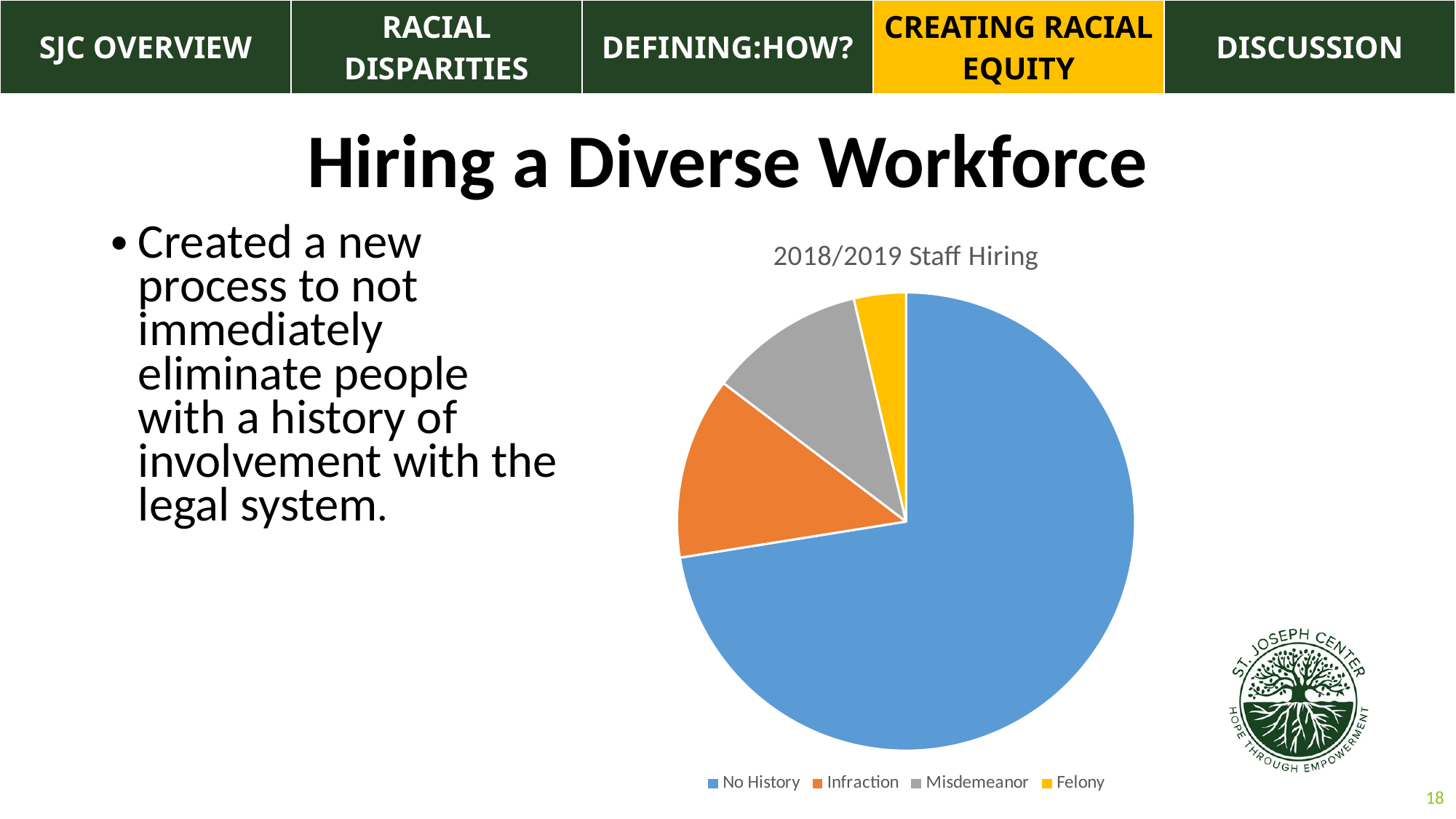
Which slice is larger, Misdemeanor or Felony? Misdemeanor Which slice is larger, No History or Infraction? No History Which slice is larger, No History or Misdemeanor? No History Which category has the largest slice in the pie chart? No History Which category has the smallest slice in the pie chart? Felony What is the title of the pie chart? 2018/2019 Staff Hiring What colour represents Felony in the pie chart? yellow How many entries does the legend of the pie chart list? 4 How many categories does the pie chart show? 4 What kind of chart is shown on the slide? pie chart